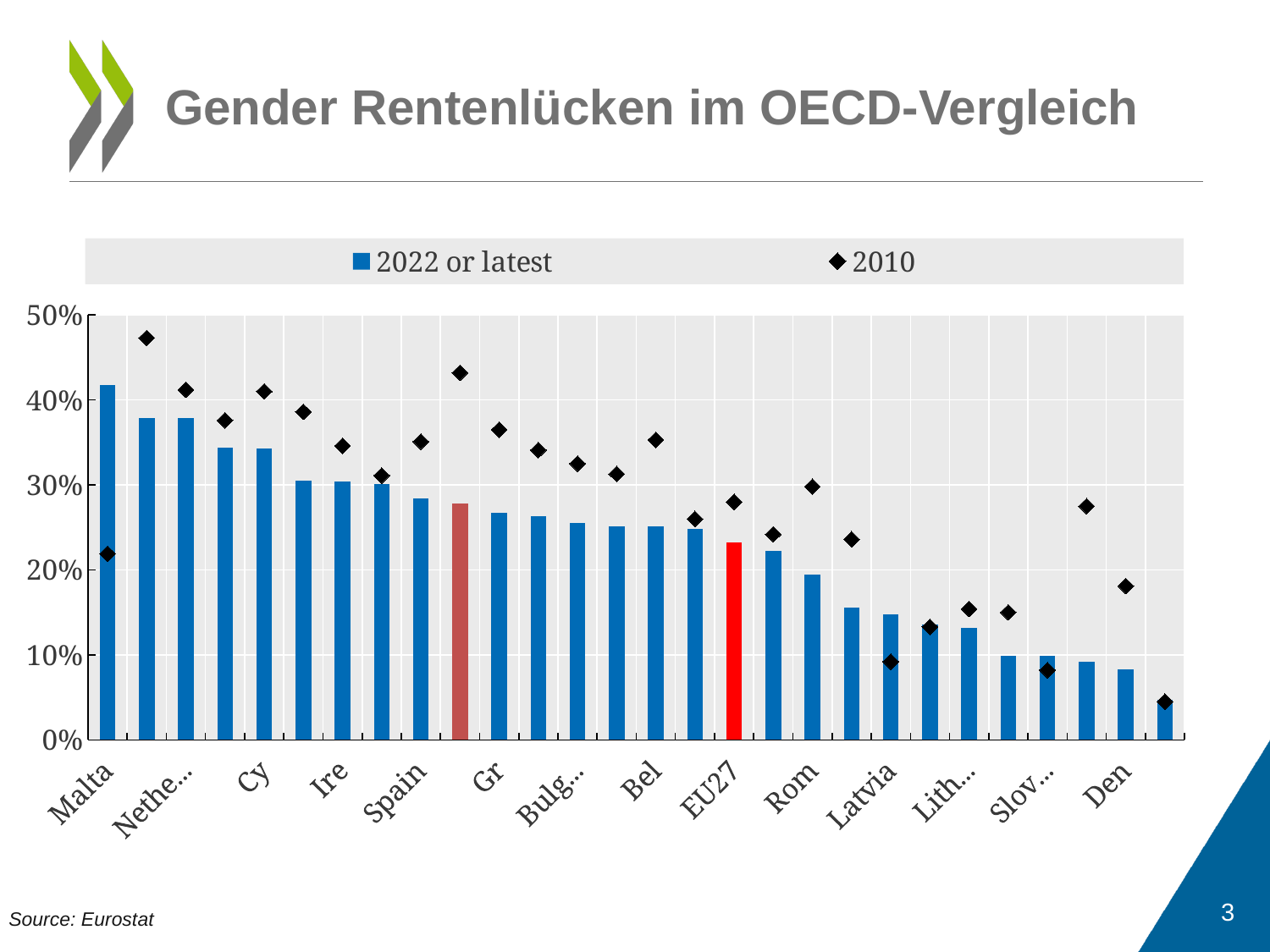
What colour is the bar for EU27? red Which is larger for Malta: the 2022 or latest value or the 2010 value? 2022 or latest Is the 2022 or latest value for EU27 greater or less than 20%? greater Is the 2022 or latest value for Malta greater or less than 40%? greater Is the 2010 value for Malta greater or less than 30%? less Which labeled country has the highest bar for 2022 or latest? Malta What are the two entries in the chart legend? 2022 or latest; 2010 How many series does the legend list? 2 Which is larger for Den: the 2022 or latest value or the 2010 value? 2010 Do the 2022 or latest bars generally rise or fall from left to right along the x axis? fall What kind of chart is shown on the slide? bar chart